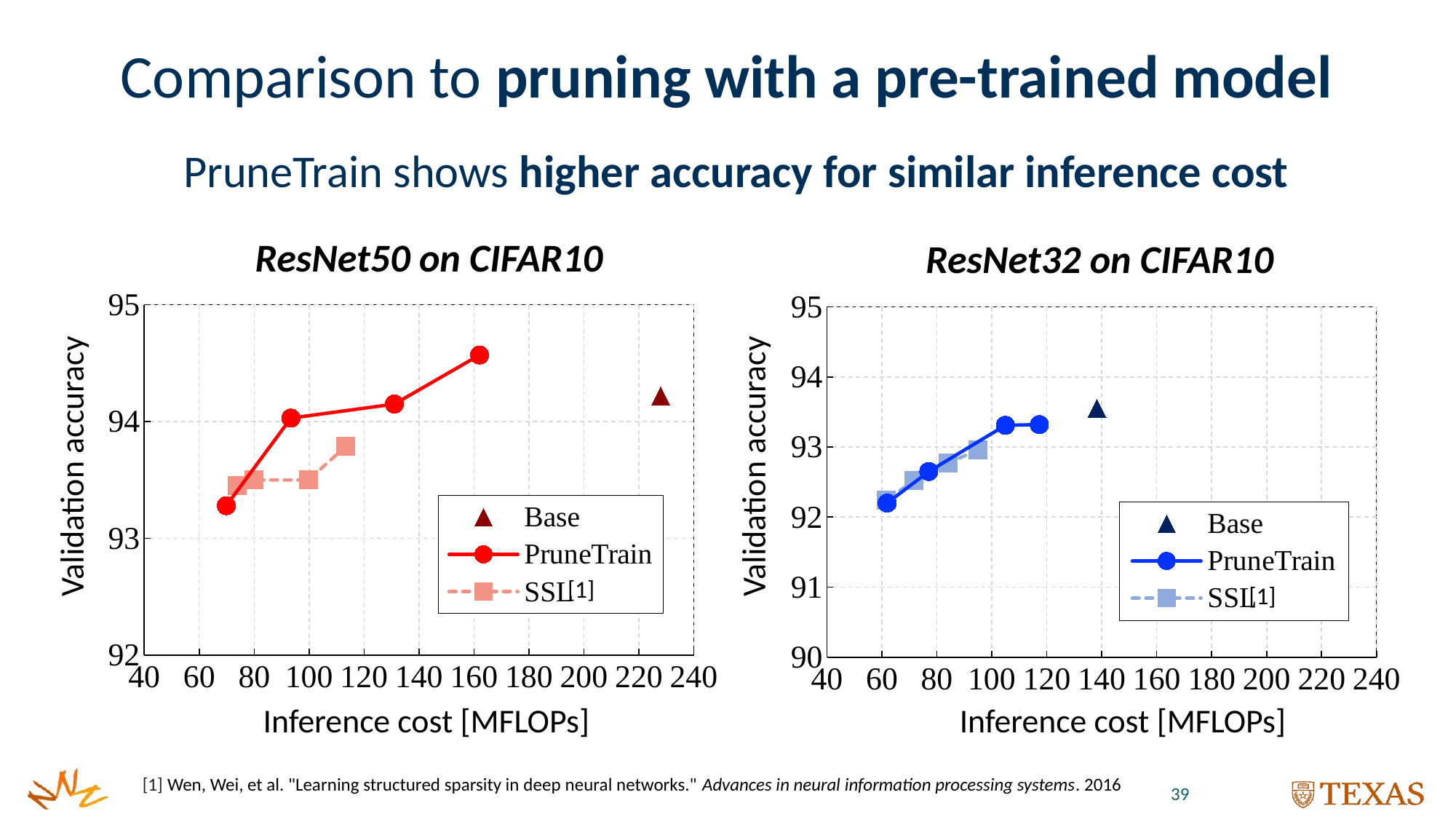
In the 'ResNet32 on CIFAR10' chart, is the inference cost of the Base point greater or less than 120 MFLOPs? greater What kind of chart is the 'ResNet50 on CIFAR10' chart? line chart In the 'ResNet50 on CIFAR10' chart, which has higher validation accuracy: the highest PruneTrain point or the Base point? PruneTrain In the 'ResNet50 on CIFAR10' chart, how many series does the legend list? 3 In the 'ResNet32 on CIFAR10' chart, how many SSL data points are plotted? 4 In the 'ResNet50 on CIFAR10' chart, is the validation accuracy of the Base point greater or less than 94? greater What is the x-axis label of the 'ResNet32 on CIFAR10' chart? Inference cost [MFLOPs] In the 'ResNet50 on CIFAR10' chart, does PruneTrain validation accuracy rise or fall as inference cost increases? rise In the 'ResNet32 on CIFAR10' chart, is the validation accuracy of the lowest-cost PruneTrain point greater or less than 93? less What is the title of the chart on the left of the slide? ResNet50 on CIFAR10 In the 'ResNet50 on CIFAR10' chart, how many PruneTrain data points are plotted? 4 In the 'ResNet32 on CIFAR10' chart, which has higher validation accuracy: the Base point or the highest PruneTrain point? Base